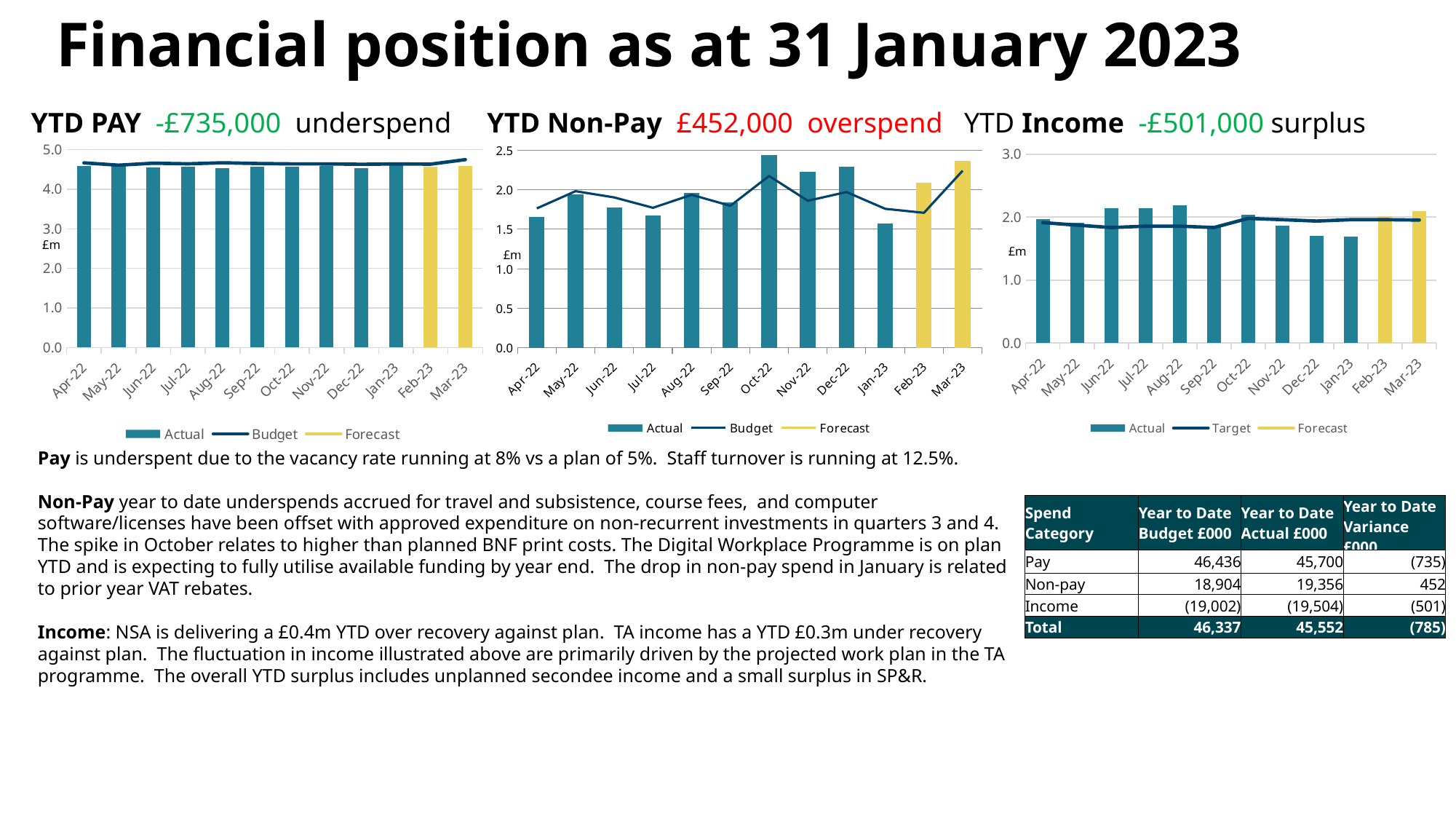
How many series does the legend of the YTD Income chart list? 3 In the YTD Non-Pay chart, which is larger, the Actual bar for Oct-22 or the Actual bar for Jan-23? Oct-22 In the YTD Income chart, is the Actual value for Dec-22 greater or less than 2.0? less What are the three legend entries of the YTD Income chart? Actual, Target, Forecast In the YTD Non-Pay chart, is the Actual value for Oct-22 greater or less than 2.0? greater In the YTD Non-Pay chart, is the Actual value for Jan-23 greater or less than 2.0? less In the YTD Non-Pay chart, which month has the lowest Actual bar? Jan-23 What unit is shown on the y axis of the YTD PAY chart? £m What kind of chart is the YTD PAY chart? combination bar and line chart In the YTD Non-Pay chart, which month has the highest Actual bar? Oct-22 How many months are shown on the x axis of the YTD Non-Pay chart? 12